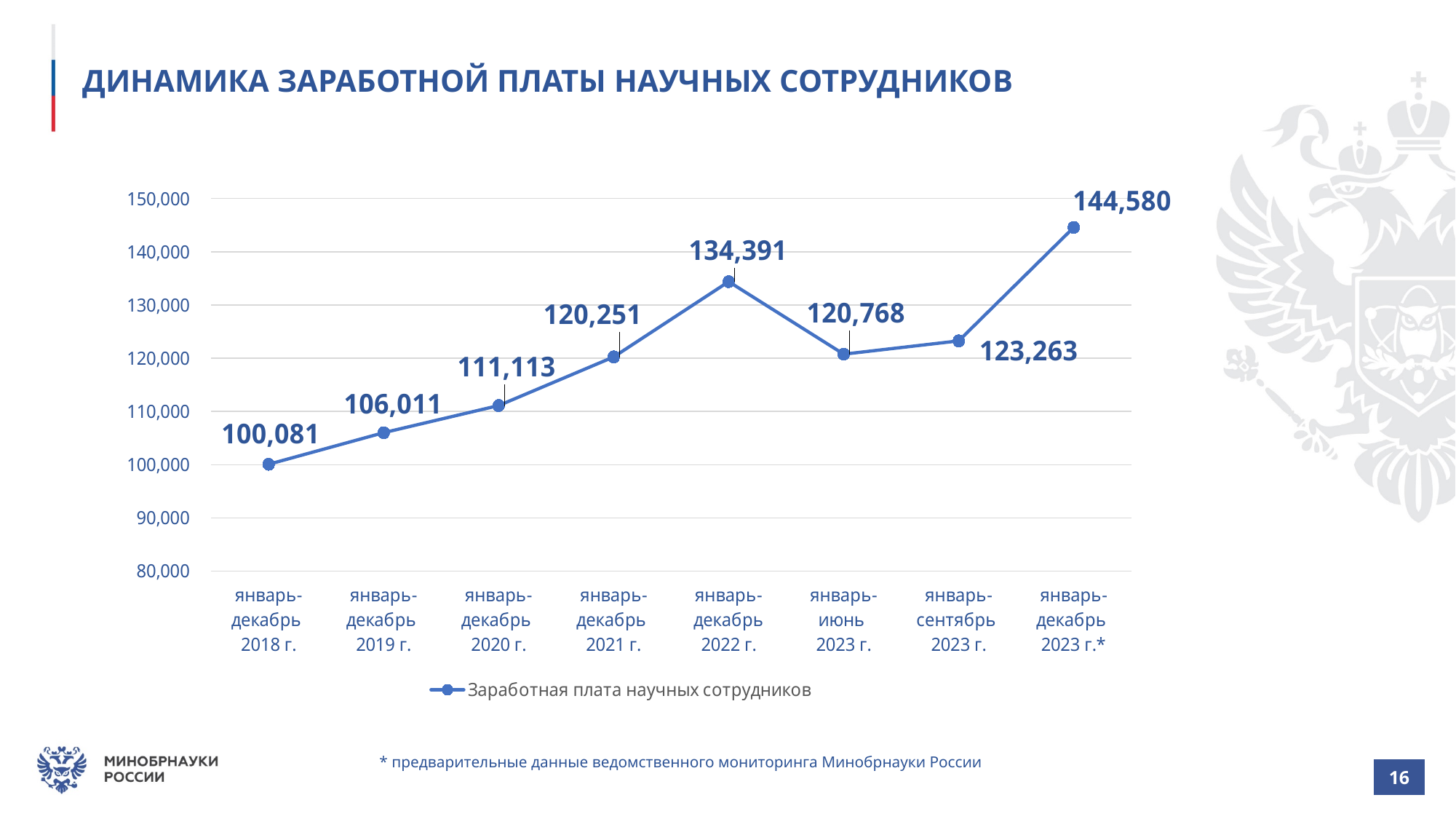
Which period has the lowest value? январь-декабрь 2018 г. How many series does the legend list? 1 What is the difference between the values for январь-декабрь 2023 г.* and январь-декабрь 2022 г.? 10,189 Which period has the highest value? январь-декабрь 2023 г.* What is the value for январь-декабрь 2018 г.? 100,081 How many periods are plotted on the x axis? 8 What is the value for январь-сентябрь 2023 г.? 123,263 What is the legend entry for the plotted series? Заработная плата научных сотрудников Is the value for январь-декабрь 2021 г. greater or less than 110,000? greater Which is larger: the value for январь-декабрь 2022 г. or the value for январь-июнь 2023 г.? январь-декабрь 2022 г. What is the value for январь-декабрь 2022 г.? 134,391 What kind of chart is shown on the slide? line chart